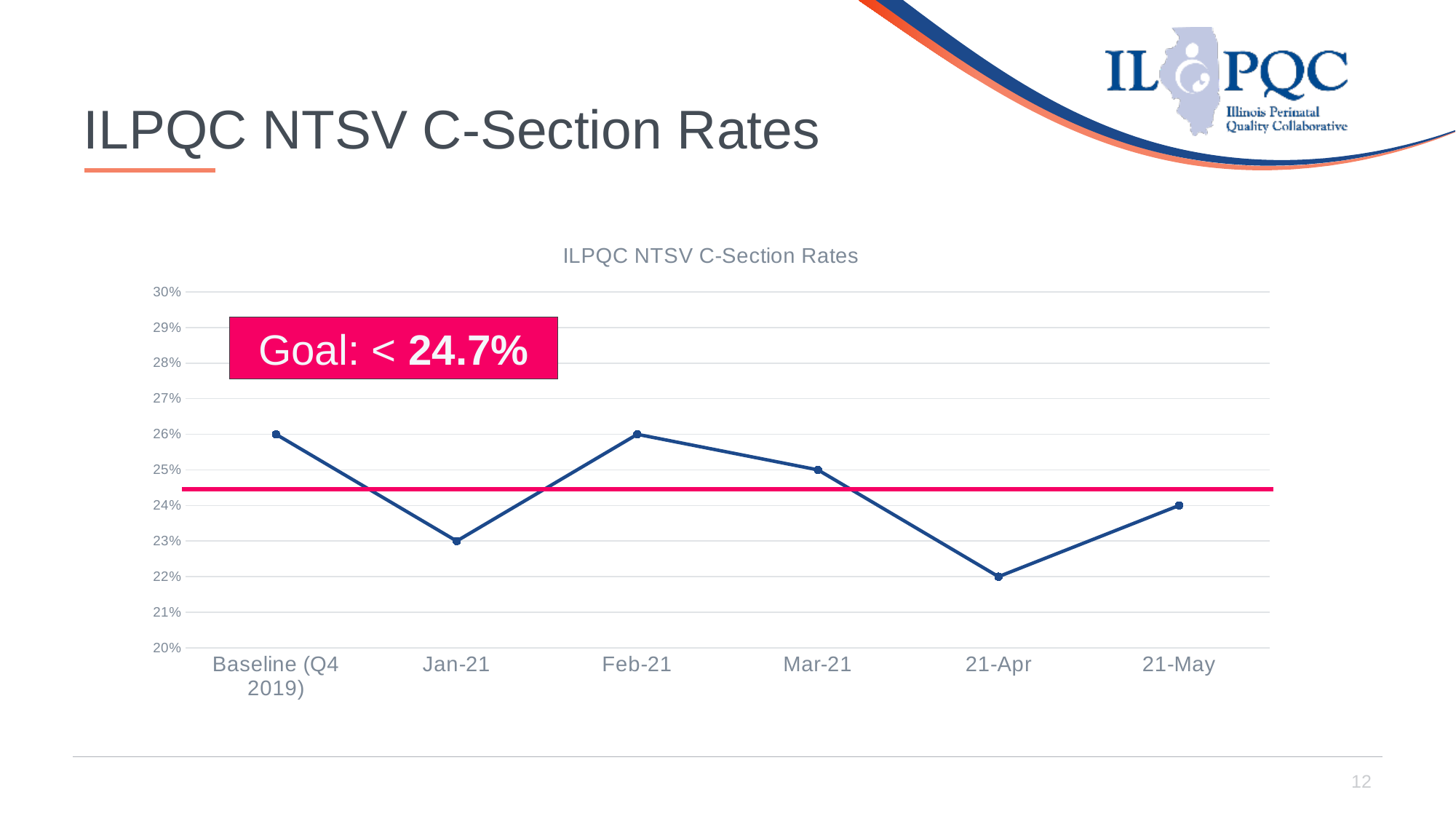
What is the difference between the Feb-21 rate and the 21-Apr rate? 4% What is the chart's title? ILPQC NTSV C-Section Rates What is the NTSV C-section rate for Jan-21? 23% Which month has the lowest NTSV C-section rate? 21-Apr What kind of chart is shown on the slide? line chart How many data points are plotted on the line? 6 What goal value is shown in the box on the chart? < 24.7% What is the NTSV C-section rate for 21-Apr? 22% Which is higher, the rate for Mar-21 or the rate for 21-May? Mar-21 What is the NTSV C-section rate for Mar-21? 25% What is the NTSV C-section rate for 21-May? 24% Is the value for Baseline (Q4 2019) greater or less than 25%? greater